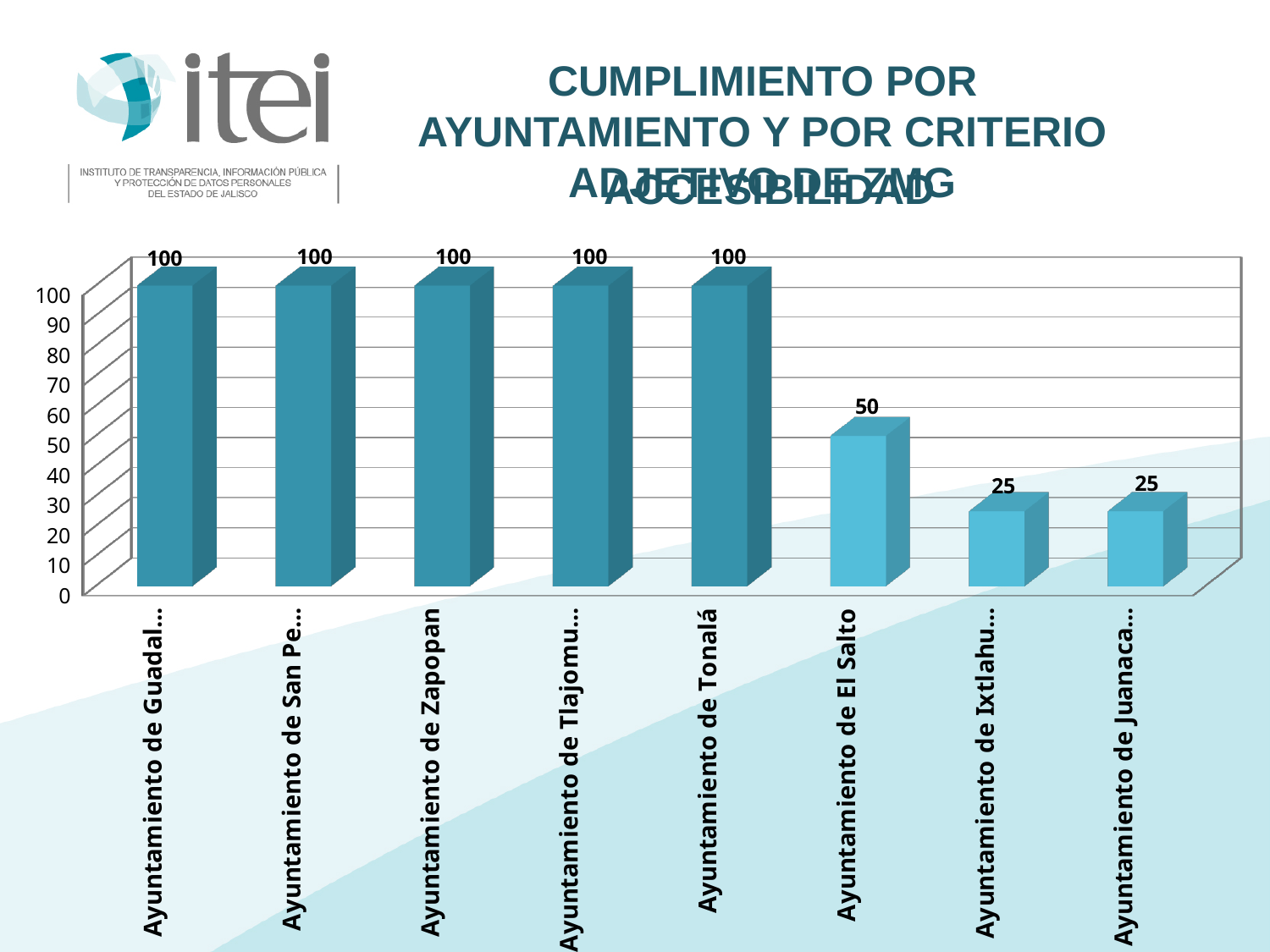
What is the difference between the values for Ayuntamiento de Tonalá and Ayuntamiento de El Salto? 50 What is the value of the last bar on the right (Ayuntamiento de Juanaca…)? 25 What kind of chart is shown on the slide? Bar chart What is the value for Ayuntamiento de Tonalá? 100 How many bars have a value of 100? 5 Is the value for Ayuntamiento de El Salto greater or less than 40? greater What is the difference between the values for Ayuntamiento de El Salto and Ayuntamiento de Juanaca…? 25 Which category has the lowest value, Ayuntamiento de El Salto or Ayuntamiento de Ixtlahu…? Ayuntamiento de Ixtlahu… What is the value for Ayuntamiento de Zapopan? 100 How many categories (bars) are shown in the chart? 8 Which is larger, the value for Ayuntamiento de Zapopan or the value for Ayuntamiento de El Salto? Ayuntamiento de Zapopan What is the value for Ayuntamiento de El Salto? 50